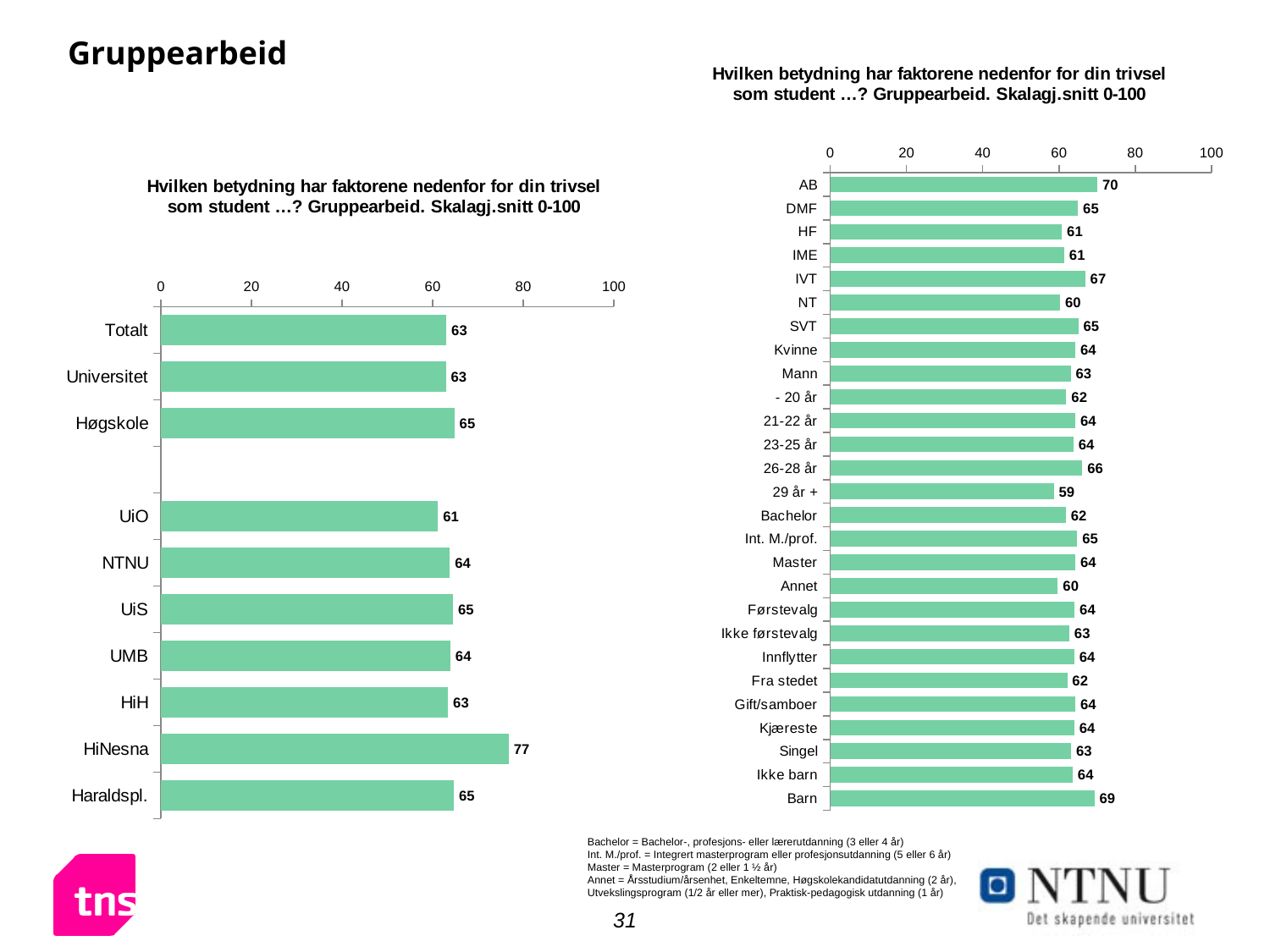
On the right chart, which is larger, the value for Barn or the value for Ikke barn? Barn On the right chart, what is the value for AB? 70 On the right chart, which category has the lowest value? 29 år + On the left chart, what is the value for Høgskole? 65 On the left chart, how many categories are plotted? 10 What kind of chart is the left chart? Bar chart On the left chart, which category has the highest value? HiNesna On the right chart, what is the difference between the values for IVT and NT? 7 On the right chart, which category has the highest value? AB On the left chart, what is the difference between the values for HiNesna and UiO? 16 On the left chart, which category has the lowest value? UiO On the left chart, what is the value for HiNesna? 77